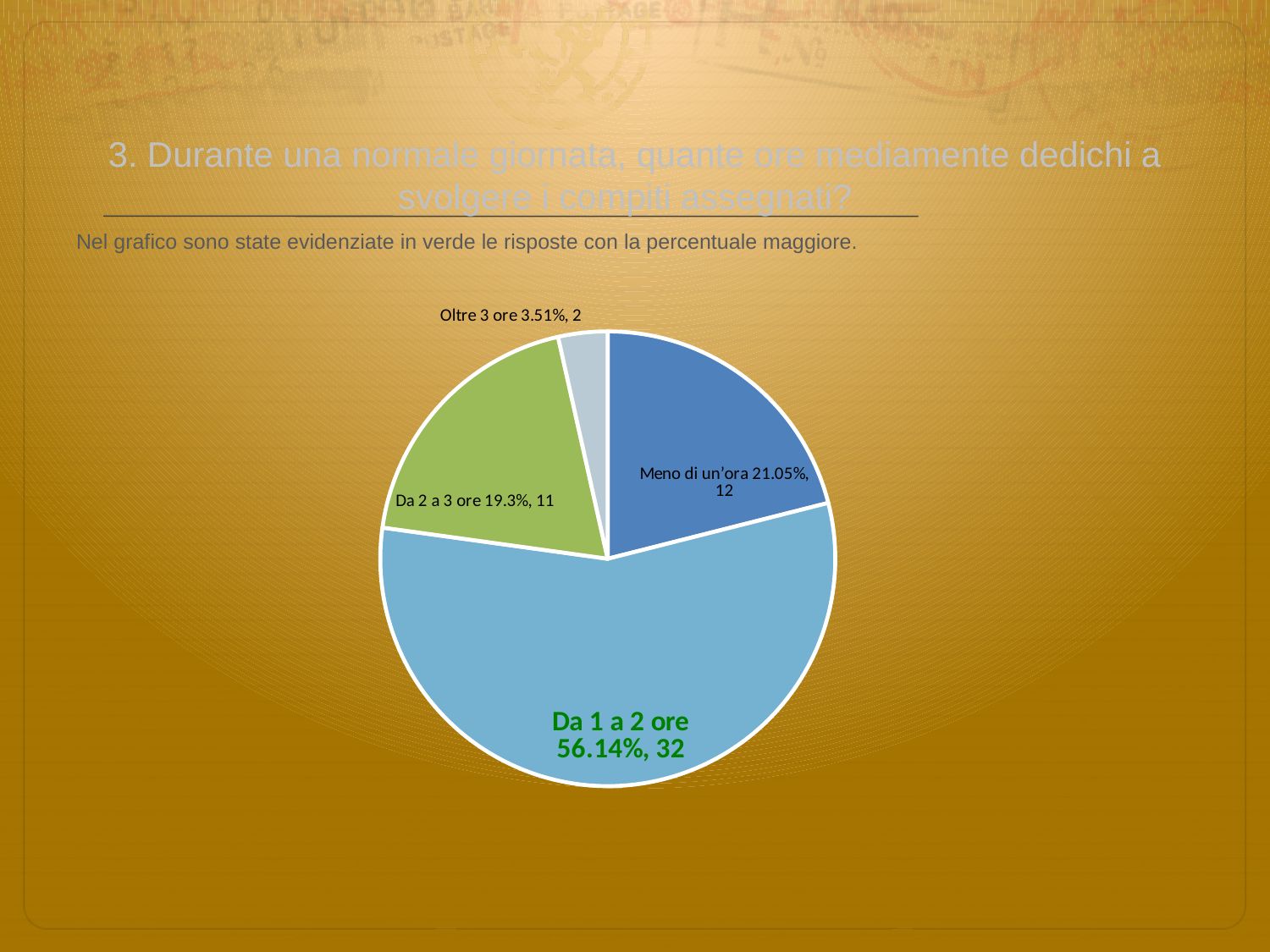
In what colour is the slice with the highest percentage highlighted, according to the slide text? green Which is larger, the count for 'Meno di un'ora' or for 'Da 2 a 3 ore'? Meno di un'ora Which category has the smallest slice? Oltre 3 ore Which category has the largest slice? Da 1 a 2 ore What percentage is shown for 'Da 2 a 3 ore'? 19.3% What is the total count across all slices of the pie chart? 57 What is the count shown for 'Meno di un'ora'? 12 What kind of chart is shown on the slide? pie chart What percentage share does the 'Da 1 a 2 ore' slice have? 56.14% How many slices does the pie chart have? 4 What is the difference in count between 'Da 1 a 2 ore' and 'Meno di un'ora'? 20 What is the count shown for 'Oltre 3 ore'? 2